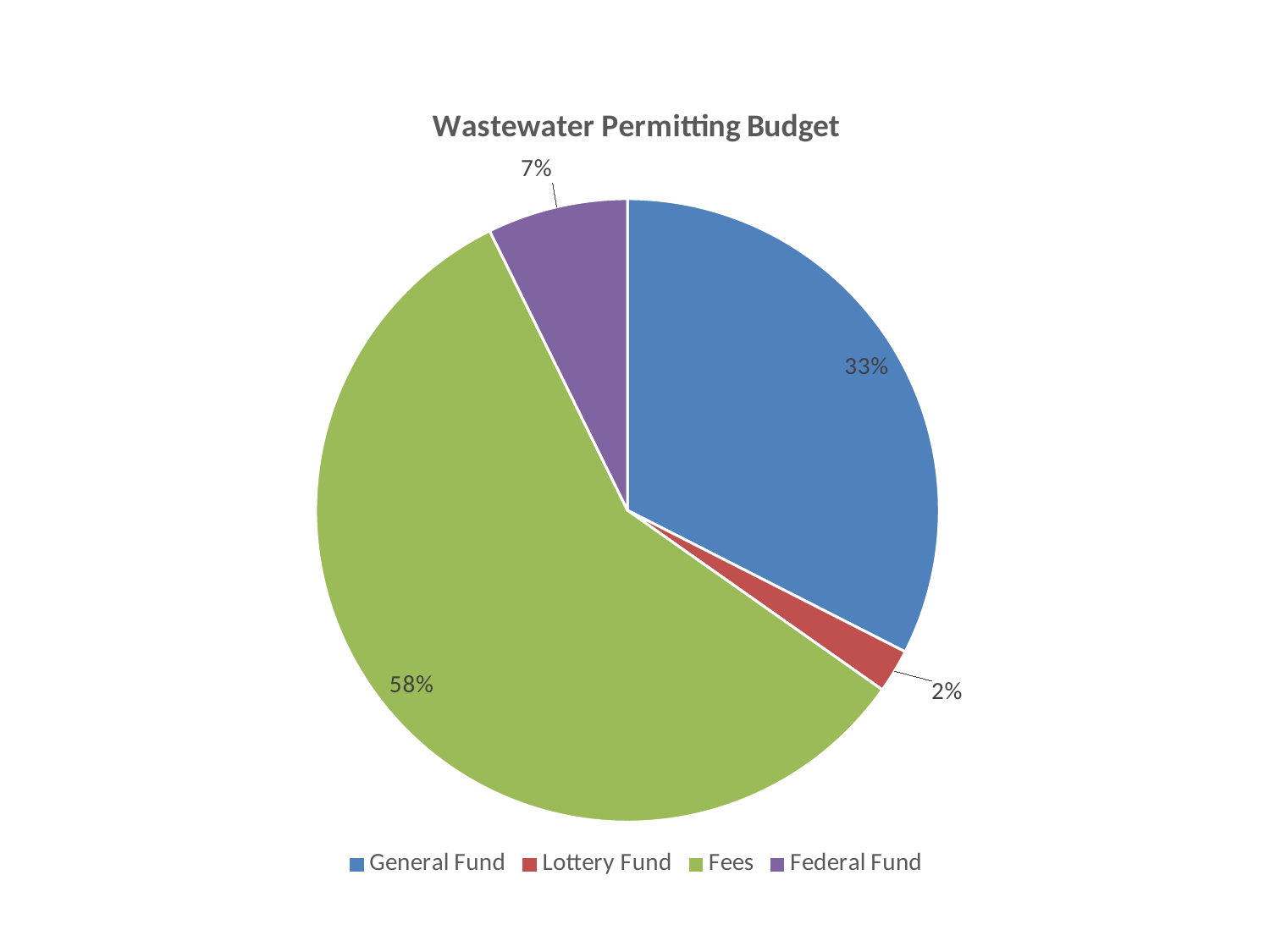
How many percentage points larger is the Federal Fund share than the Lottery Fund share? 5 What share of the Wastewater Permitting Budget comes from the Federal Fund? 7% What type of chart is shown on the slide? Pie chart What is the title of the chart? Wastewater Permitting Budget Which is larger: the General Fund share or the Federal Fund share? General Fund What share of the Wastewater Permitting Budget comes from the Lottery Fund? 2% How many percentage points larger is the Fees share than the General Fund share? 25 Which funding source makes up the smallest share of the Wastewater Permitting Budget? Lottery Fund What share of the Wastewater Permitting Budget comes from Fees? 58% Which funding source makes up the largest share of the Wastewater Permitting Budget? Fees How many funding sources are shown in the pie chart? 4 What share of the Wastewater Permitting Budget comes from the General Fund? 33%